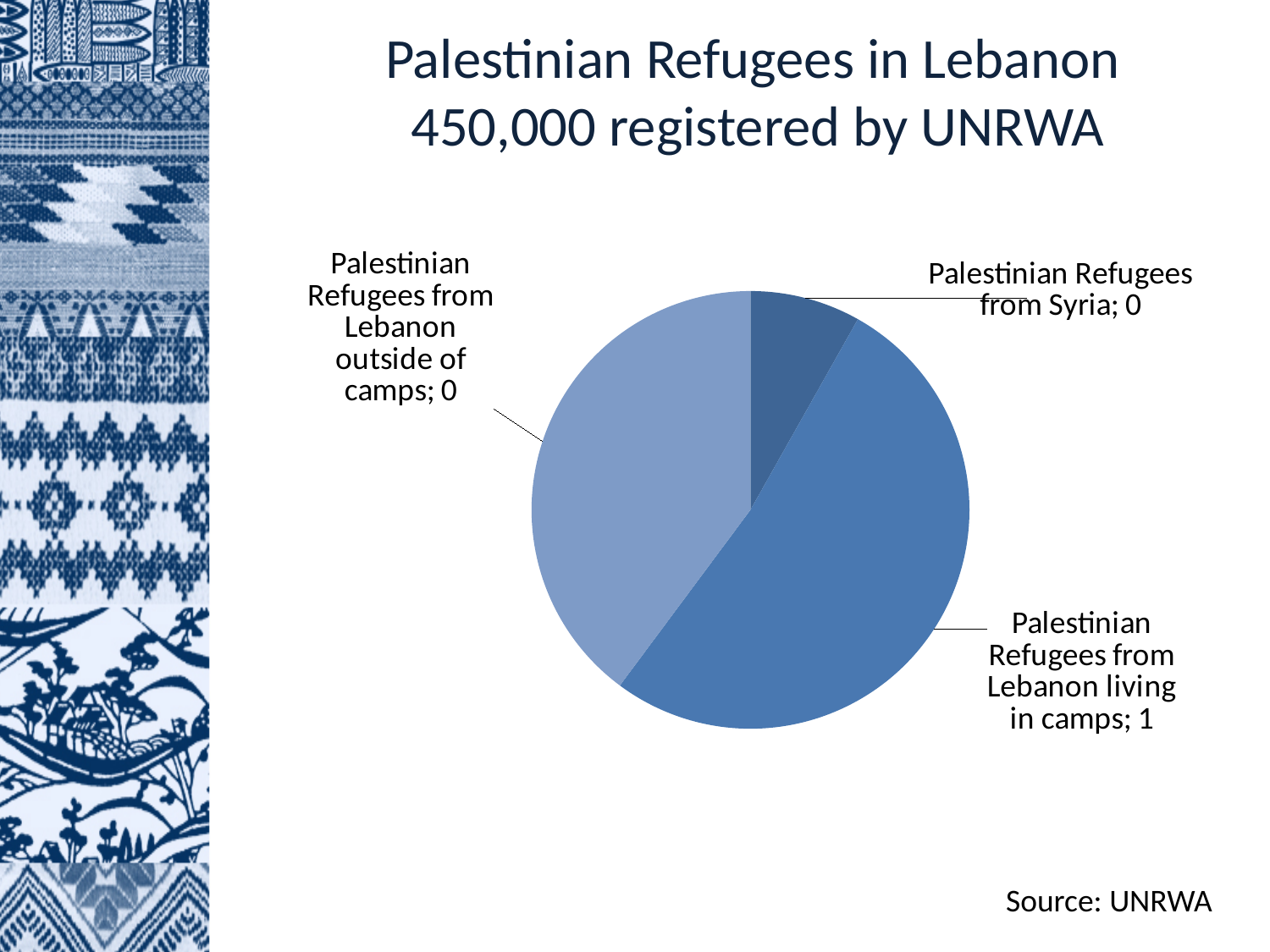
Which category has the smallest slice of the pie chart? Palestinian Refugees from Syria What is the title of the slide containing the pie chart? Palestinian Refugees in Lebanon 450,000 registered by UNRWA Which category has the largest slice of the pie chart? Palestinian Refugees from Lebanon living in camps What data label value is shown for Palestinian Refugees from Lebanon outside of camps? 0 Which slice is larger: Palestinian Refugees from Lebanon living in camps or Palestinian Refugees from Lebanon outside of camps? Palestinian Refugees from Lebanon living in camps What data label value is shown for Palestinian Refugees from Syria? 0 What source is cited for the pie chart data? UNRWA How many slices does the pie chart have? 3 What data label value is shown for Palestinian Refugees from Lebanon living in camps? 1 What kind of chart is shown on the slide? pie chart Which slice is larger: Palestinian Refugees from Lebanon outside of camps or Palestinian Refugees from Syria? Palestinian Refugees from Lebanon outside of camps